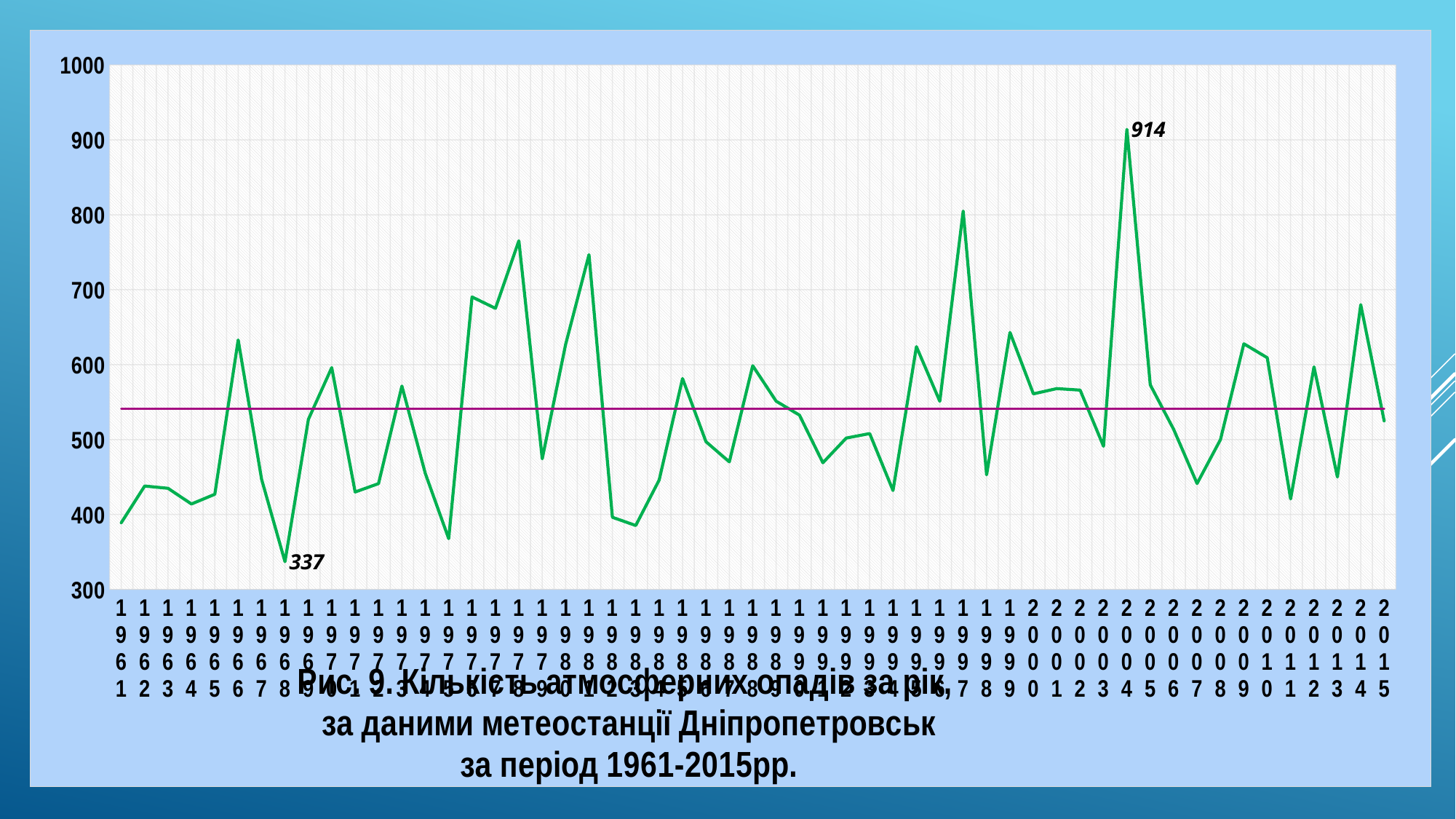
What is the labelled value for 1968? 337 What is the labelled value for 2004? 914 What is the difference between the highest labelled value (2004) and the lowest labelled value (1968)? 577 Do the values rise or fall from 2004 to 2007? fall Is the value for 1977 greater or less than 700? less What figure number is given in the chart caption? Рис. 9 Is the value for 1975 greater or less than 400? less What kind of chart is shown on the slide? line chart In which year was the annual precipitation lowest? 1968 Which year has the larger value, 2004 or 1997? 2004 How many years (data points) are plotted along the x axis? 55 In which year was the annual precipitation highest? 2004